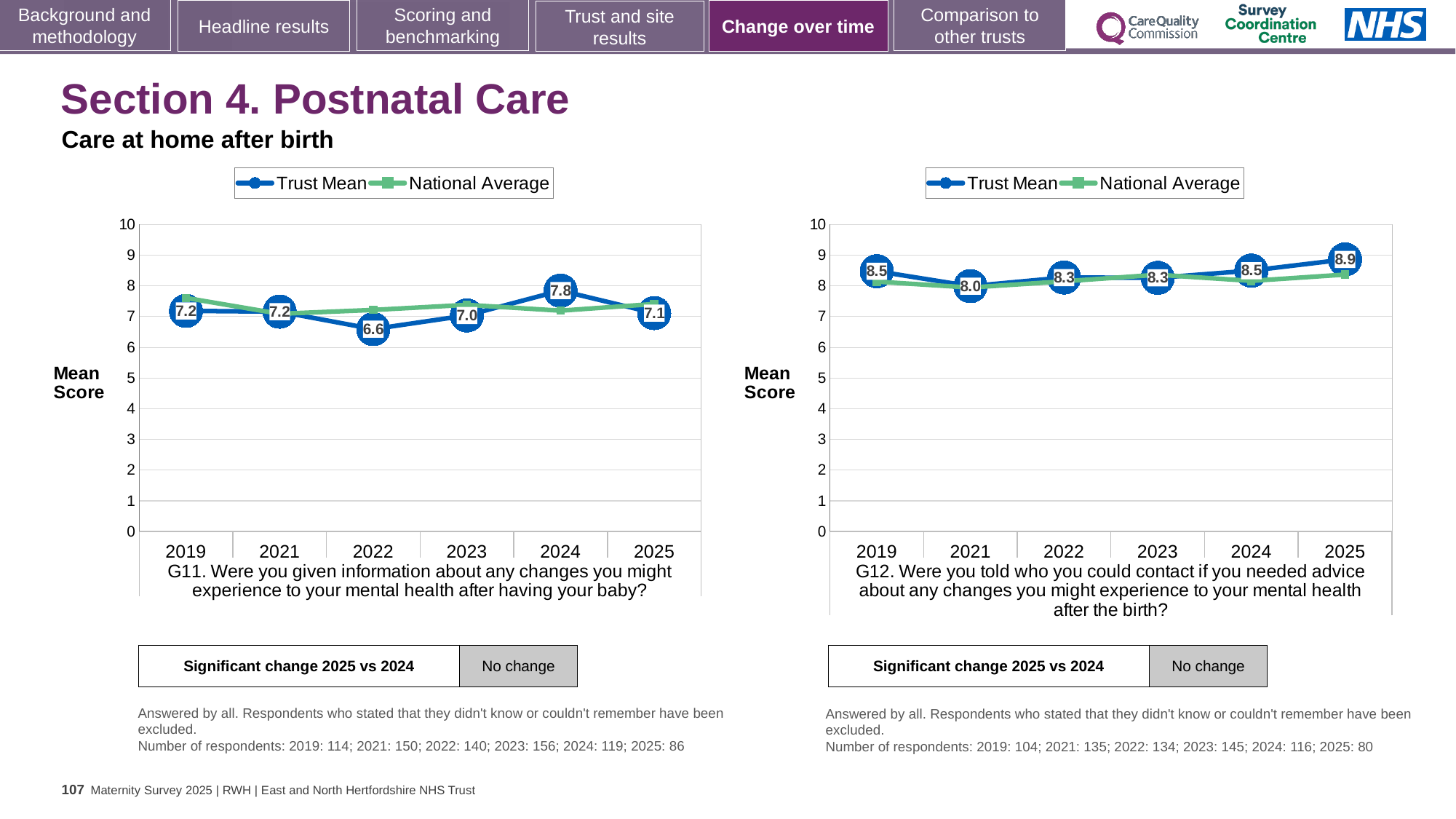
How many series does the legend of the left chart (G11) list? 2 In the right chart (G12), what is the difference between the Trust Mean for 2025 and the Trust Mean for 2021? 0.9 In the left chart (G11), what is the Trust Mean for 2024? 7.8 In the left chart (G11), which year has the highest Trust Mean? 2024 In the left chart (G11), which year has the lowest Trust Mean? 2022 In the right chart (G12), what is the Trust Mean for 2025? 8.9 In the left chart (G11), what is the Trust Mean for 2022? 6.6 In the left chart (G11), what is the difference between the Trust Mean for 2024 and the Trust Mean for 2022? 1.2 What kind of chart is the right chart (G12)? line chart In the right chart (G12), which year has the lowest Trust Mean? 2021 In the right chart (G12), what is the Trust Mean for 2021? 8.0 In the right chart (G12), is the Trust Mean for 2025 greater or less than 8? greater